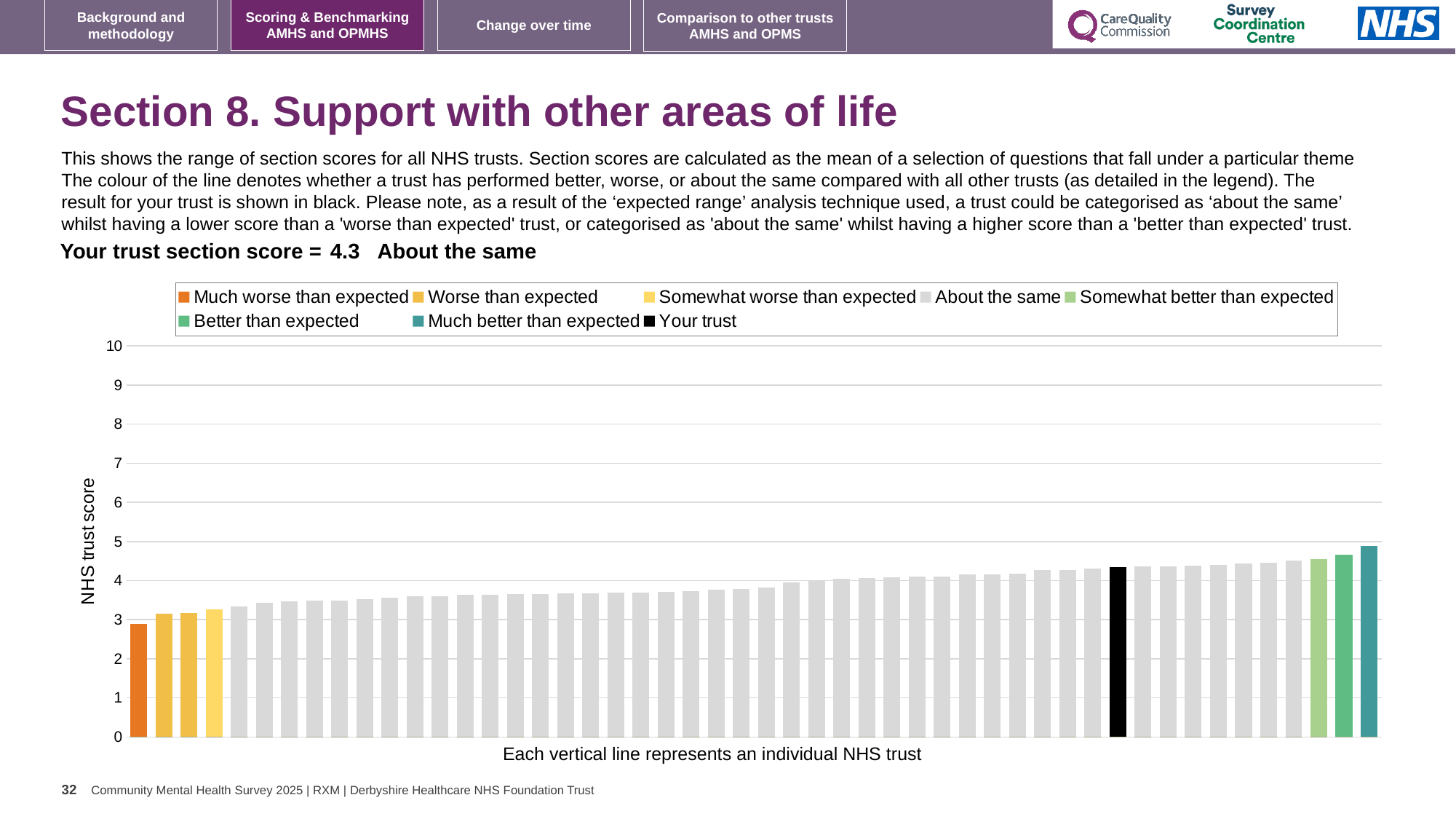
What kind of chart is shown on the slide? Bar chart Is the value for your trust (the black bar) greater or less than 4? greater Do the bar values rise or fall from left to right along the x axis? Rise Which legend category does the tallest bar belong to? Much better than expected Is the value of the tallest bar greater or less than 4? greater Is the value of the orange (Much worse than expected) bar greater or less than 4? less Which is taller: the black 'Your trust' bar or the orange 'Much worse than expected' bar? Your trust How many entries does the chart legend list? 8 What is the title of the vertical axis? NHS trust score Which legend category does the shortest bar belong to? Much worse than expected How many bars are coloured orange (Much worse than expected)? 1 What is the section score for your trust? 4.3